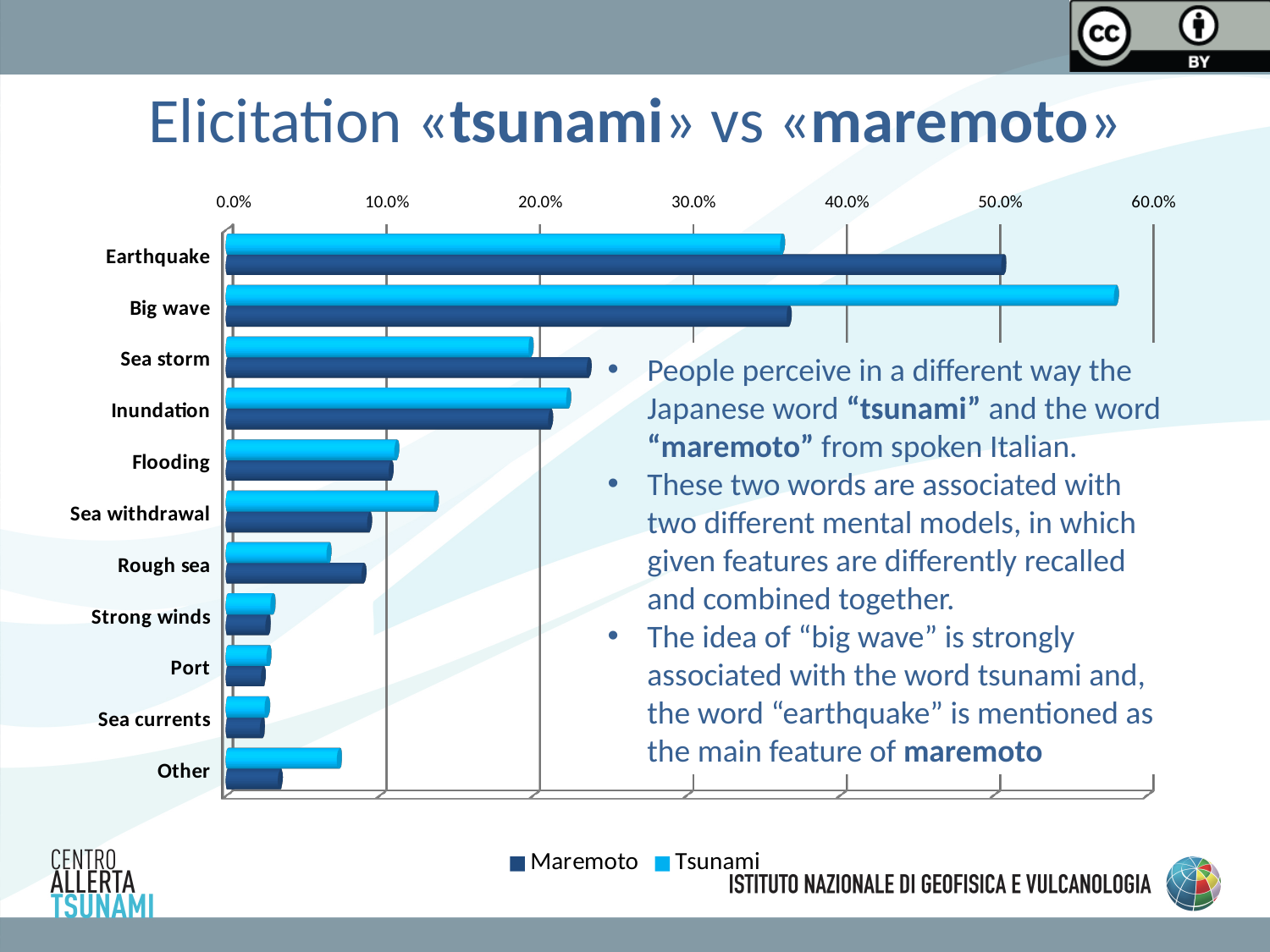
For Other, which series has the larger value, Maremoto or Tsunami? Tsunami What kind of chart is shown on the slide? Bar chart Which category has the highest value for the Maremoto series? Earthquake How many categories are plotted on the chart? 11 Which category has the highest value for the Tsunami series? Big wave For Big wave, which series has the larger value, Maremoto or Tsunami? Tsunami For Earthquake, which series has the larger value, Maremoto or Tsunami? Maremoto Is the Tsunami value for Big wave greater or less than 50.0%? greater Is the Tsunami value for Sea storm greater or less than 30.0%? less Is the Maremoto value for Earthquake greater or less than 40.0%? greater How many series does the chart legend list? 2 Which series is shown in dark blue in the legend? Maremoto